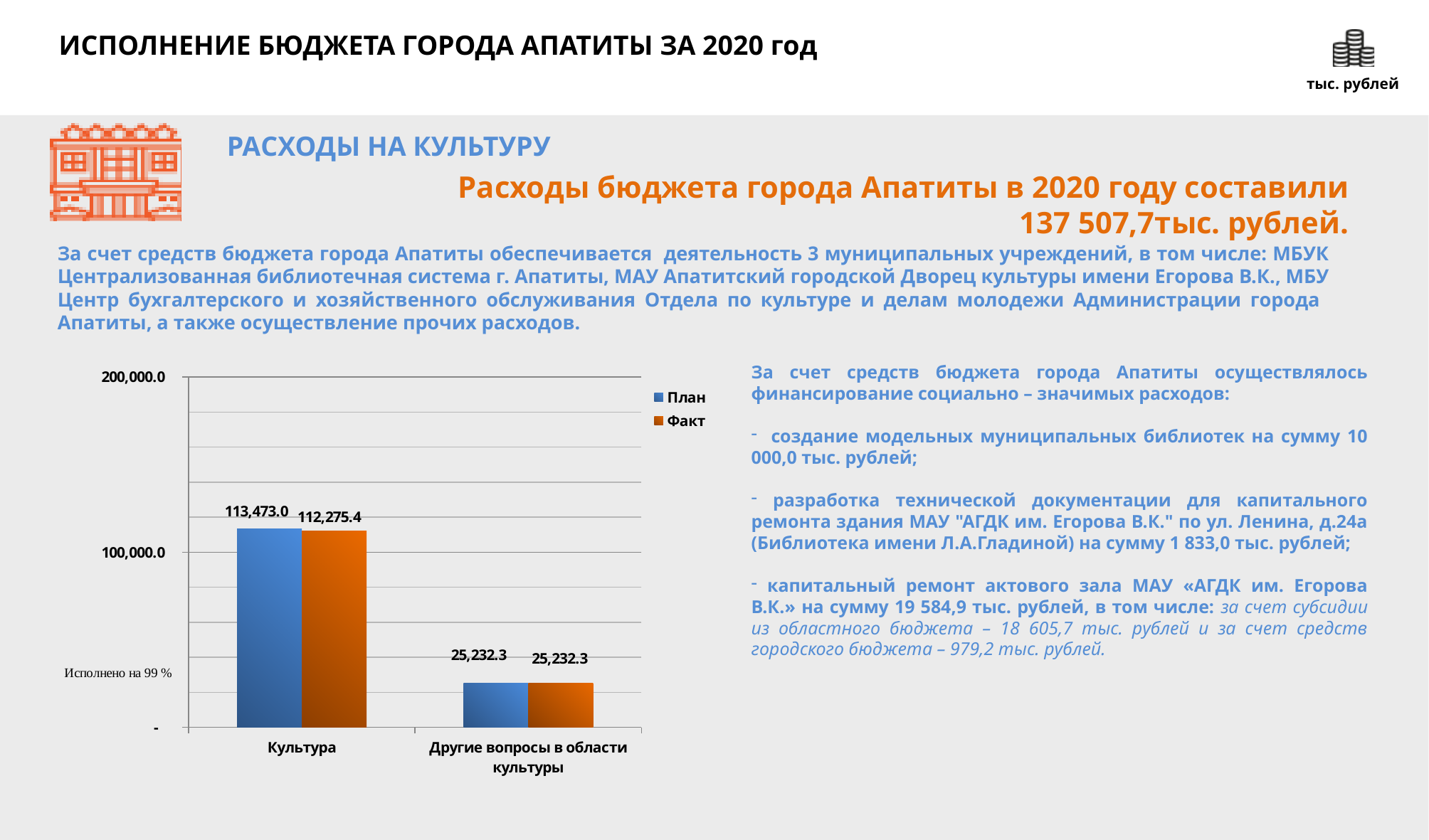
Which is larger for Культура, the План value or the Факт value? План How many series does the chart legend list? 2 What is the План value for Культура? 113,473.0 What is the Факт value for Другие вопросы в области культуры? 25,232.3 What is the difference between the План and Факт values for Культура? 1,197.6 How many categories are shown on the x axis of the chart? 2 Which category has the lowest План value? Другие вопросы в области культуры Is the Факт value for Культура greater or less than 100,000.0? greater What kind of chart is shown on the slide? bar chart What is the План value for Другие вопросы в области культуры? 25,232.3 What is the Факт value for Культура? 112,275.4 Which category has the highest Факт value? Культура